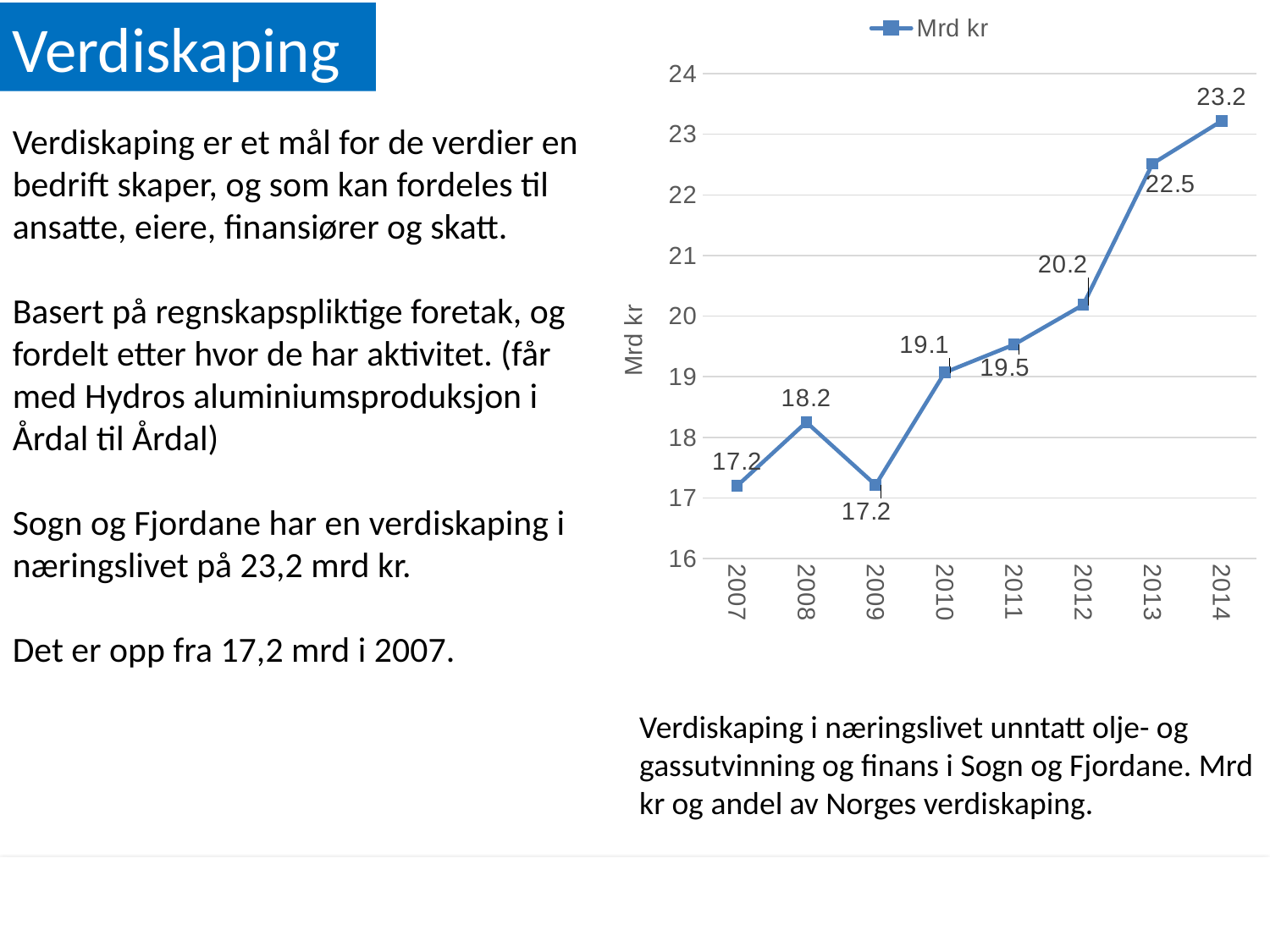
How many series does the legend list? 1 Which year has the highest value? 2014 What type of chart is shown on the slide? line chart What is the difference between the values for 2014 and 2007? 6.0 What is the label of the y axis? Mrd kr What is the value for 2012? 20.2 Is the value for 2013 greater or less than 22? greater What is the difference between the values for 2013 and 2012? 2.3 What is the value for 2010? 19.1 How many years are plotted on the x axis? 8 Which is larger, the value for 2008 or the value for 2009? 2008 What is the value for 2014? 23.2